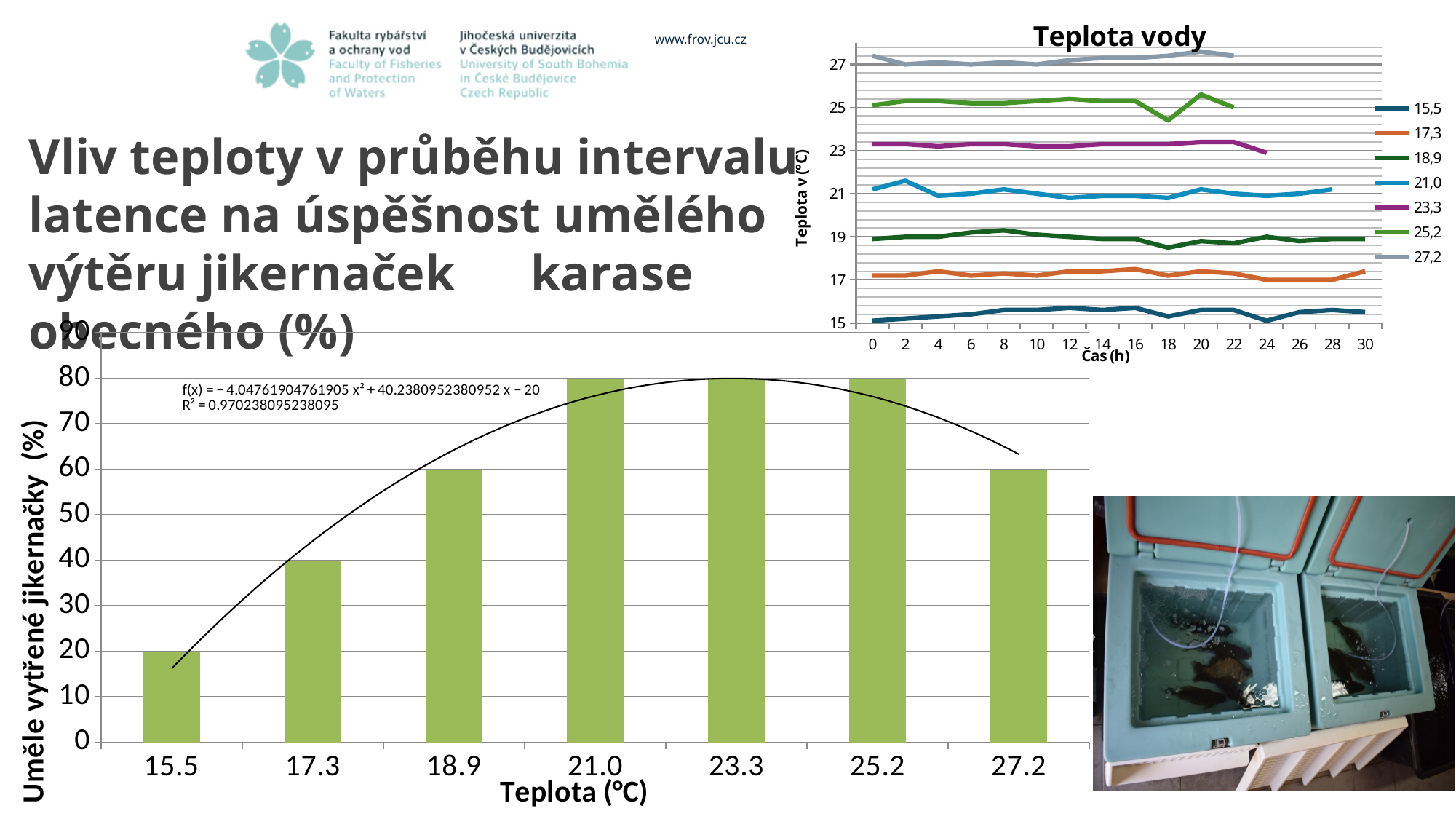
In the bar chart at the bottom left, which temperature has the lowest percentage of artificially spawned females? 15.5 How many temperature categories are shown in the bar chart at the bottom left? 7 What kind of chart is the chart at the bottom left of the slide? Bar chart What is the title of the line chart at the top right of the slide? Teplota vody In the bar chart at the bottom left, what is the value for the temperature 17.3 °C? 40 In the bar chart at the bottom left, do the values rise or fall from 15.5 °C to 21.0 °C? Rise In the 'Teplota vody' chart, is the value of the 27,2 series at 0 h greater or less than 25? greater In the bar chart at the bottom left, what is the value for the temperature 27.2 °C? 60 In the bar chart at the bottom left, what is the difference between the values for 21.0 °C and 15.5 °C? 60 How many series does the legend of the 'Teplota vody' chart list? 7 In the bar chart at the bottom left, what is the value for the temperature 15.5 °C? 20 In the bar chart at the bottom left, which is larger: the value for 18.9 °C or the value for 17.3 °C? 18.9 °C